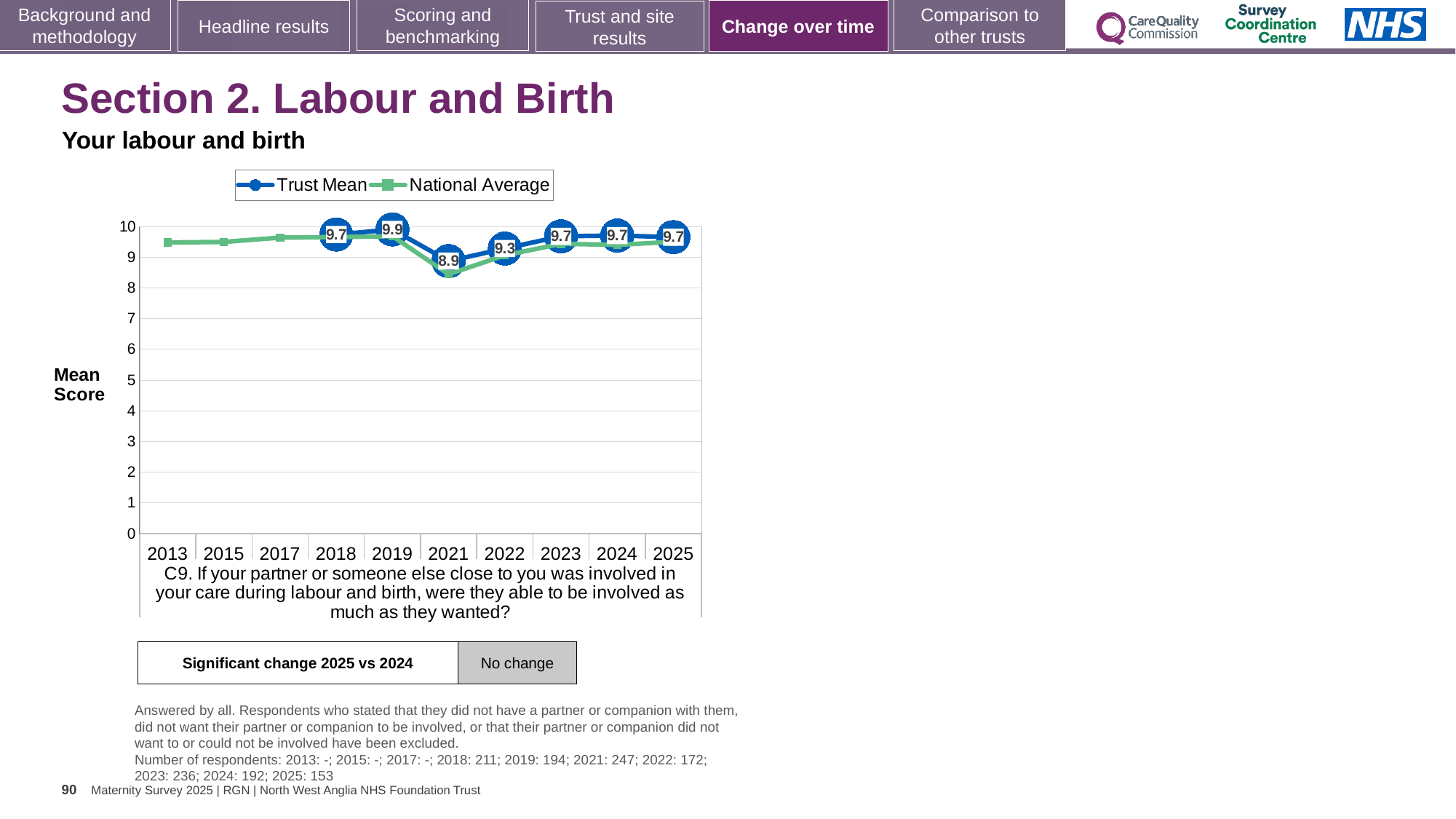
Does the Trust Mean score rise or fall from 2021 to 2023? rise What is the Trust Mean score for 2021? 8.9 What is the Trust Mean score for 2025? 9.7 How many years are shown on the x axis? 10 What is the Trust Mean score for 2019? 9.9 In which year is the Trust Mean score lowest? 2021 Is the National Average value for 2013 greater or less than 9? greater Which year has the larger Trust Mean score, 2022 or 2023? 2023 In which year is the Trust Mean score highest? 2019 What kind of chart is shown on the slide? line chart How many series does the legend list? 2 What is the difference between the Trust Mean scores for 2019 and 2021? 1.0